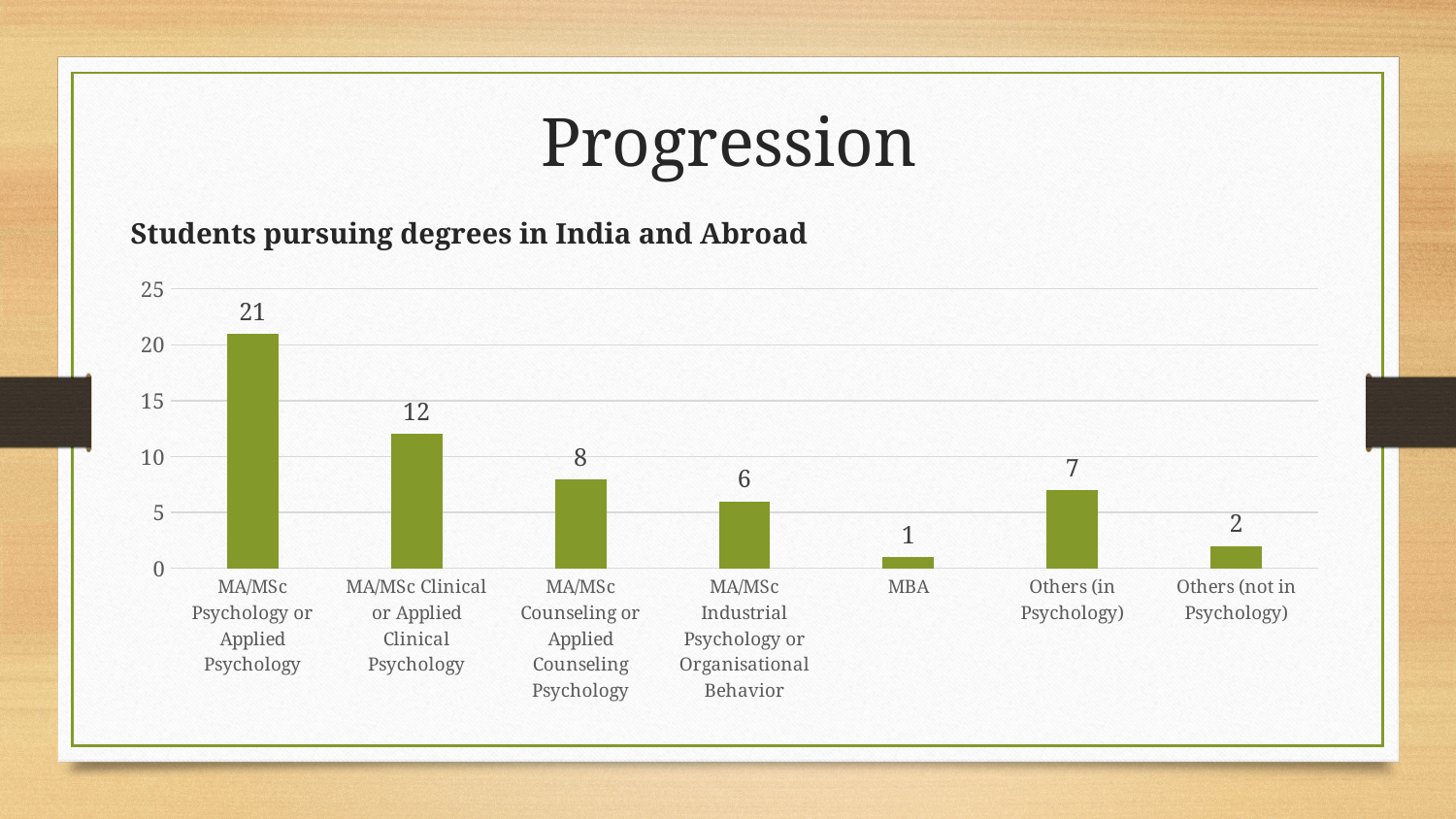
What is the value for MA/MSc Clinical or Applied Clinical Psychology? 12 How many students are pursuing an MA/MSc Psychology or Applied Psychology? 21 How many categories are shown on the chart? 7 Is the value for MA/MSc Industrial Psychology or Organisational Behavior greater or less than 10? less What kind of chart is shown on the slide? bar chart What is the value for MBA? 1 What is the value for Others (in Psychology)? 7 Which category has the highest value? MA/MSc Psychology or Applied Psychology What is the difference between the values for MA/MSc Psychology or Applied Psychology and MA/MSc Clinical or Applied Clinical Psychology? 9 Which category has the lowest value? MBA What is the title of the chart? Students pursuing degrees in India and Abroad Which is larger: the value for MA/MSc Counseling or Applied Counseling Psychology or the value for Others (in Psychology)? MA/MSc Counseling or Applied Counseling Psychology